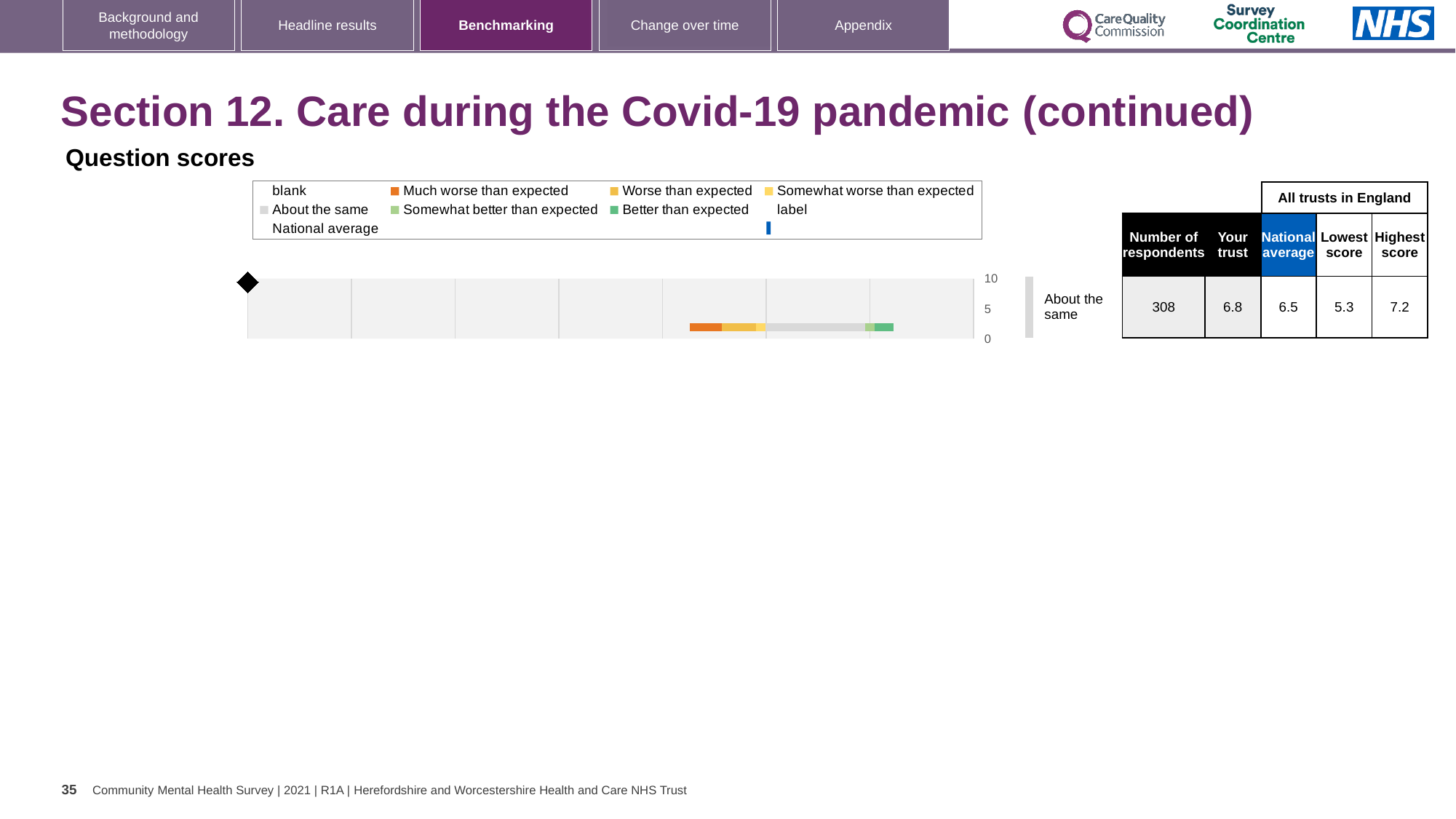
Which is larger, the highest score in England or the 'Your trust' score? Highest score Which is larger, the 'Your trust' score or the national average? Your trust What is the national average score shown in the table? 6.5 What is the difference between the 'Your trust' score and the national average? 0.3 What kind of chart is used to show the question score? Bar chart How many respondents are shown for this question? 308 What is the lowest score among all trusts in England shown in the table? 5.3 What benchmark category label is shown next to the chart for this question? About the same What is the maximum value shown on the chart's numeric axis? 10 What is the difference between the highest score and the lowest score among all trusts in England? 1.9 What is the highest score among all trusts in England shown in the table? 7.2 What is the 'Your trust' score shown for the question in Section 12? 6.8